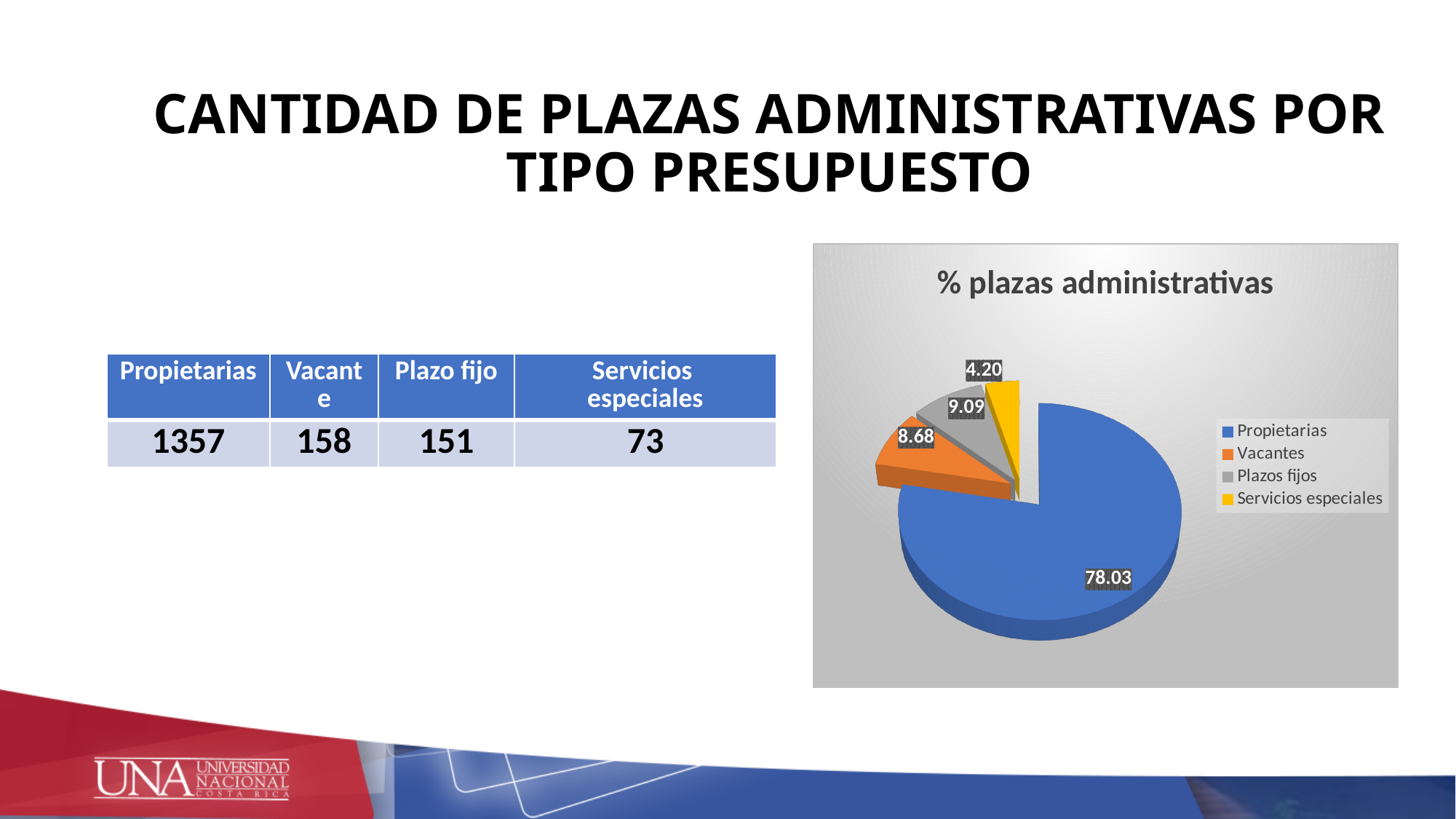
What value is shown for the Servicios especiales slice? 4.20 What is the title of the chart? % plazas administrativas What is the difference between the Propietarias value and the Plazos fijos value? 68.94 Which is larger, the Plazos fijos slice or the Vacantes slice? Plazos fijos Which category has the smallest slice of the pie? Servicios especiales What value is shown for the Vacantes slice? 8.68 Which category has the largest slice of the pie? Propietarias What colour is the Servicios especiales slice? Yellow What value is shown for the Plazos fijos slice? 9.09 What value is shown for the Propietarias slice? 78.03 How many categories does the legend list? 4 What type of chart is shown on the slide? Pie chart